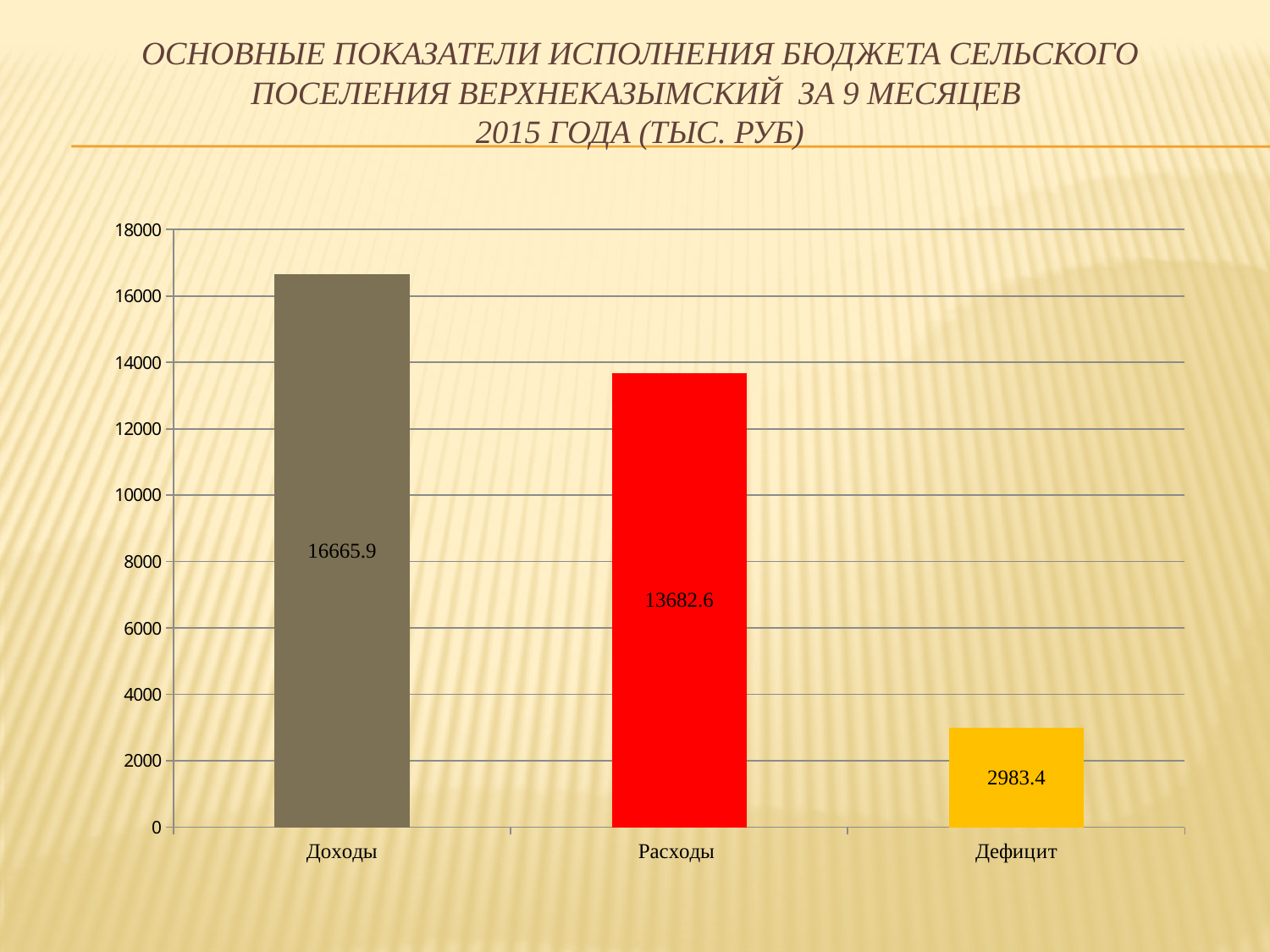
Is the value for Дефицит greater or less than 2000? greater How many categories are shown on the chart? 3 What is the value for Расходы? 13682.6 Which category has the lowest value? Дефицит Which category has the highest value? Доходы What is the value for Доходы? 16665.9 What kind of chart is shown on the slide? bar chart Is the value for Расходы greater or less than 14000? less Which is larger, the value for Расходы or the value for Дефицит? Расходы What is the value for Дефицит? 2983.4 What is the difference between the values for Доходы and Расходы? 2983.3 What colour is the bar for Расходы? red